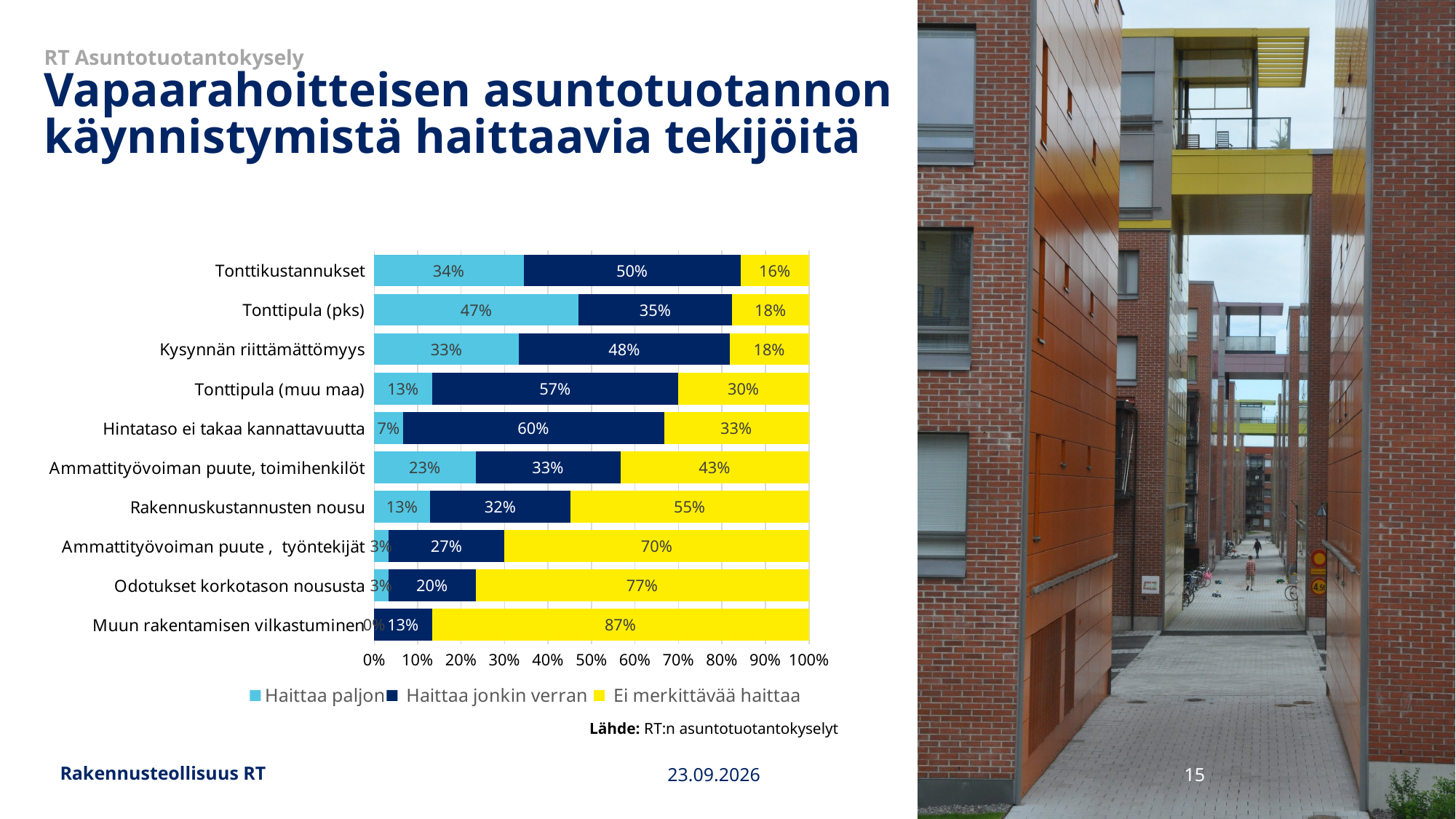
Which category has the highest "Haittaa paljon" share? Tonttipula (pks) Which is larger: the "Haittaa paljon" value for Tonttikustannukset or for Kysynnän riittämättömyys? Tonttikustannukset What is the "Ei merkittävää haittaa" value for Muun rakentamisen vilkastuminen? 87% What is the difference between the "Ei merkittävää haittaa" values for Odotukset korkotason noususta and Rakennuskustannusten nousu? 22 percentage points What is the combined share of "Haittaa paljon" and "Haittaa jonkin verran" for Tonttipula (muu maa)? 70% What percentage of respondents answered "Haittaa paljon" for Tonttipula (pks)? 47% Which colour represents "Ei merkittävää haittaa" in the chart? Yellow What is the "Haittaa jonkin verran" value for Hintataso ei takaa kannattavuutta? 60% How many series does the legend list? 3 What type of chart is shown on the slide? Stacked bar chart How many categories are shown in the chart? 10 Which category has the lowest "Ei merkittävää haittaa" share? Tonttikustannukset